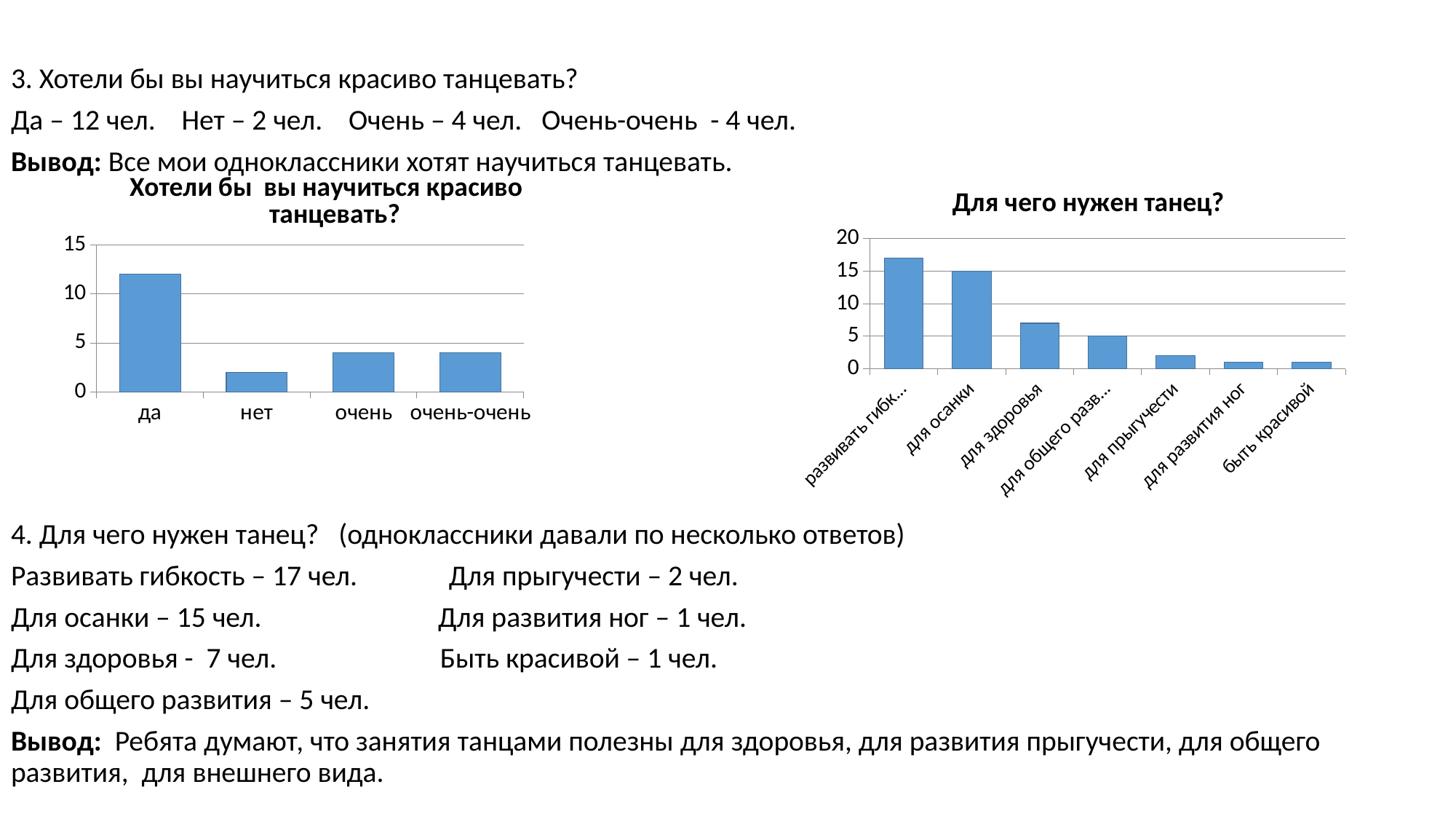
In the right chart "Для чего нужен танец?", which category has the highest bar? развивать гибкость In the left chart "Хотели бы вы научиться красиво танцевать?", what is the value for "да"? 12 In the right chart "Для чего нужен танец?", which is larger: the value for "для здоровья" or the value for "для прыгучести"? для здоровья In the right chart "Для чего нужен танец?", what is the difference between the values for "для осанки" and "для общего развития"? 10 What kind of chart is the left chart titled "Хотели бы вы научиться красиво танцевать?"? bar chart In the left chart "Хотели бы вы научиться красиво танцевать?", which category has the highest bar? да In the right chart "Для чего нужен танец?", is the value for "для здоровья" greater or less than 5? greater In the right chart "Для чего нужен танец?", how many categories are shown on the x axis? 7 In the left chart "Хотели бы вы научиться красиво танцевать?", is the value for "нет" greater or less than 5? less In the left chart "Хотели бы вы научиться красиво танцевать?", how many categories are shown on the x axis? 4 In the right chart "Для чего нужен танец?", what is the value for "для осанки"? 15 In the left chart "Хотели бы вы научиться красиво танцевать?", which category has the lowest bar? нет